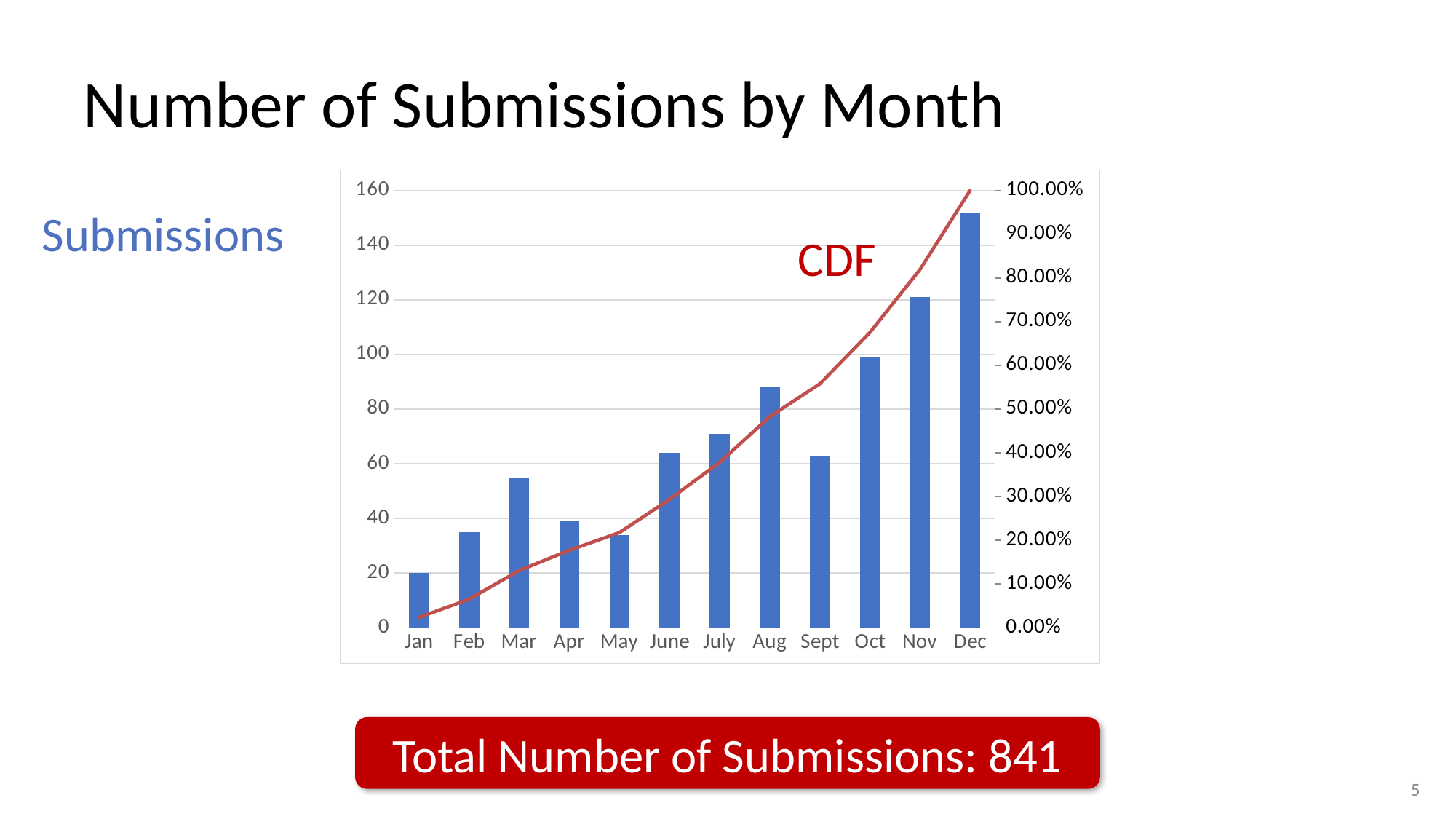
What is the label of the red line in the chart? CDF What kind of chart is shown on the slide? bar chart with a line Which month has the highest number of submissions? Dec Which month has more submissions, Mar or Apr? Mar Is the value for May greater or less than 60? less Which month has the lowest number of submissions? Jan How many months are shown on the x axis of the chart? 12 Is the value for Jan greater or less than 40? less Is the value for Nov greater or less than 100? greater Which month has more submissions, Aug or Sept? Aug Do the submissions generally rise or fall from Jan to Dec? rise